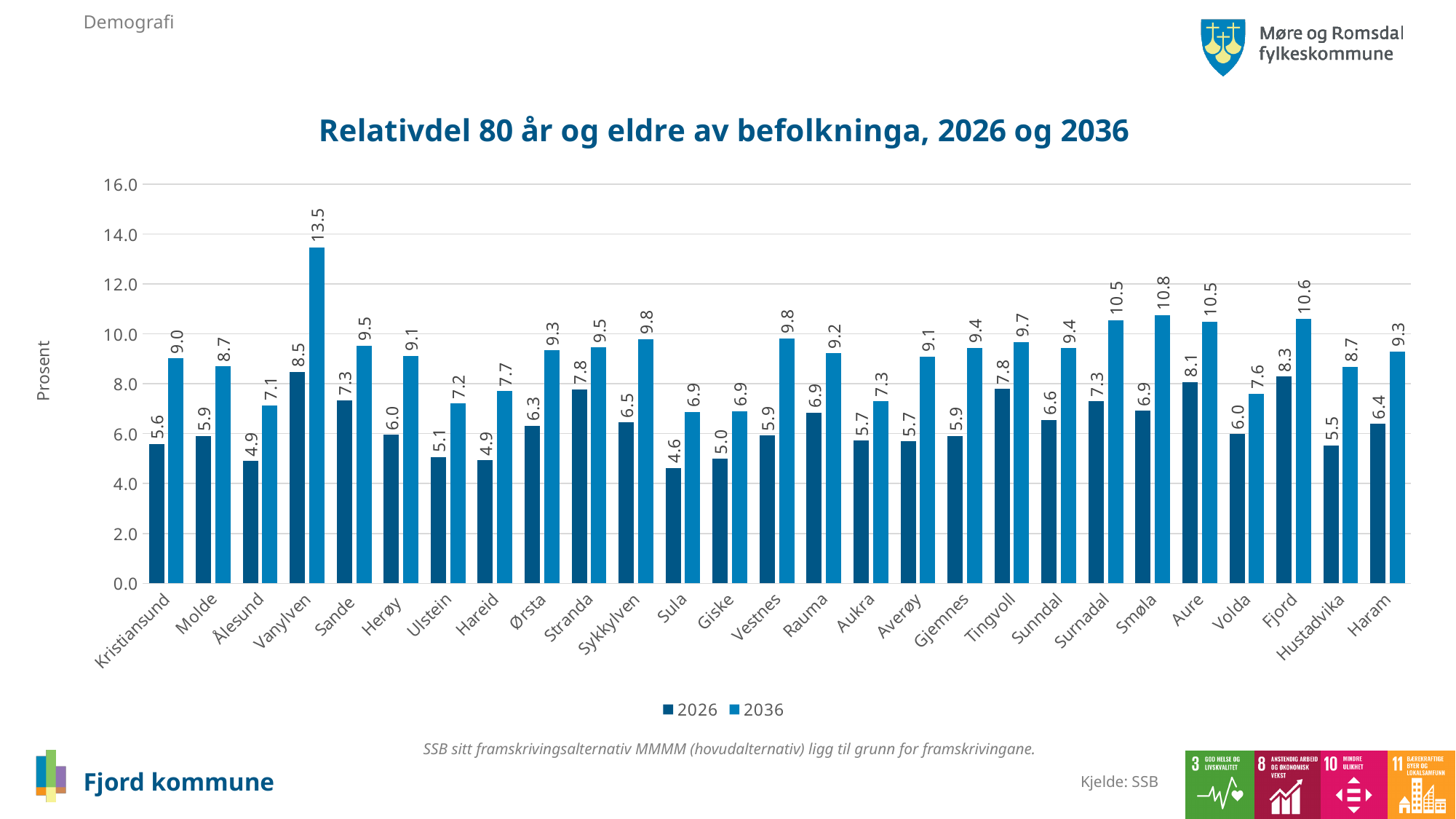
Is the 2036 value for Surnadal greater or less than 10.0? greater Which municipality has the highest value in the 2036 series? Vanylven Which municipality has the lowest value in the 2026 series? Sula What is the difference between the 2036 and 2026 values for Kristiansund? 3.4 How many municipalities are shown on the x axis? 27 Which is larger: the 2026 value for Aure or the 2026 value for Stranda? Aure What is the difference between the 2036 and 2026 values for Vanylven? 5.0 What kind of chart is shown on the slide? Bar chart What is the value for Vanylven in the 2036 series? 13.5 How many series does the legend list? 2 What is the value for Smøla in the 2036 series? 10.8 What is the value for Fjord in the 2026 series? 8.3